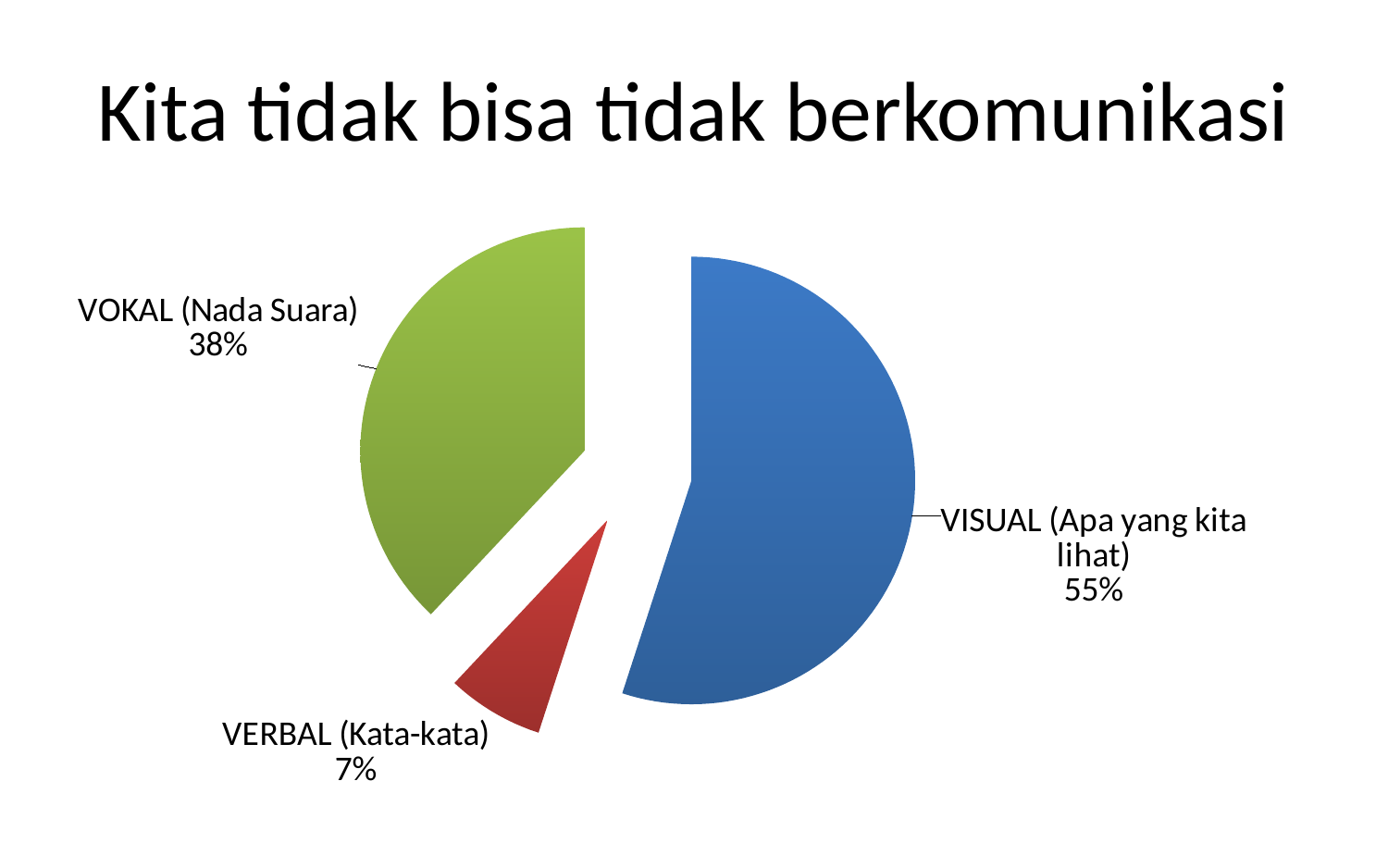
Which is larger, the share for VOKAL (Nada Suara) or the share for VERBAL (Kata-kata)? VOKAL (Nada Suara) Which slice of the pie is the largest? VISUAL (Apa yang kita lihat) What is the difference in percentage points between VOKAL (Nada Suara) and VERBAL (Kata-kata)? 31 What colour is the VISUAL (Apa yang kita lihat) slice? blue How many slices does the pie chart have? 3 What share of the pie does VOKAL (Nada Suara) have? 38% Which slice of the pie is the smallest? VERBAL (Kata-kata) What share of the pie does VISUAL (Apa yang kita lihat) have? 55% What kind of chart is shown on the slide? pie chart What is the difference in percentage points between VISUAL (Apa yang kita lihat) and VOKAL (Nada Suara)? 17 What share of the pie does VERBAL (Kata-kata) have? 7% What is the title of the slide? Kita tidak bisa tidak berkomunikasi